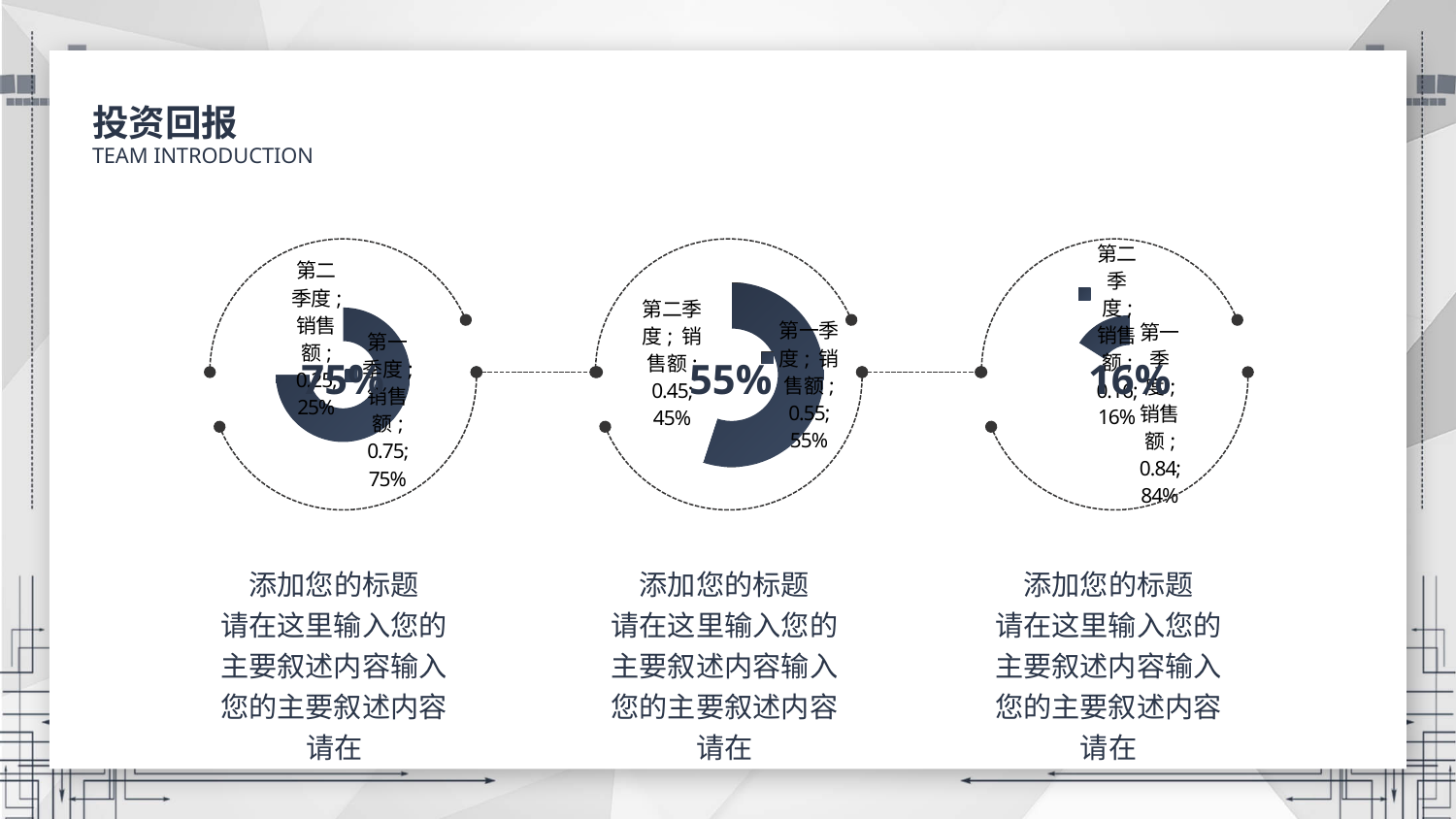
In the left chart, which category has the smallest slice? 第二季度 In the right chart, what share does 第二季度 销售额 have? 16% In the left chart, what share does 第二季度 销售额 have? 25% In the left chart, what share does 第一季度 销售额 have? 75% How many slices does the middle chart have? 2 What kind of chart is the left chart? doughnut chart In the right chart, which slice is larger, 第一季度 or 第二季度? 第一季度 What large percentage is printed in the centre of the right chart? 16% In the middle chart, what is the difference between the 第一季度 and 第二季度 shares? 10%